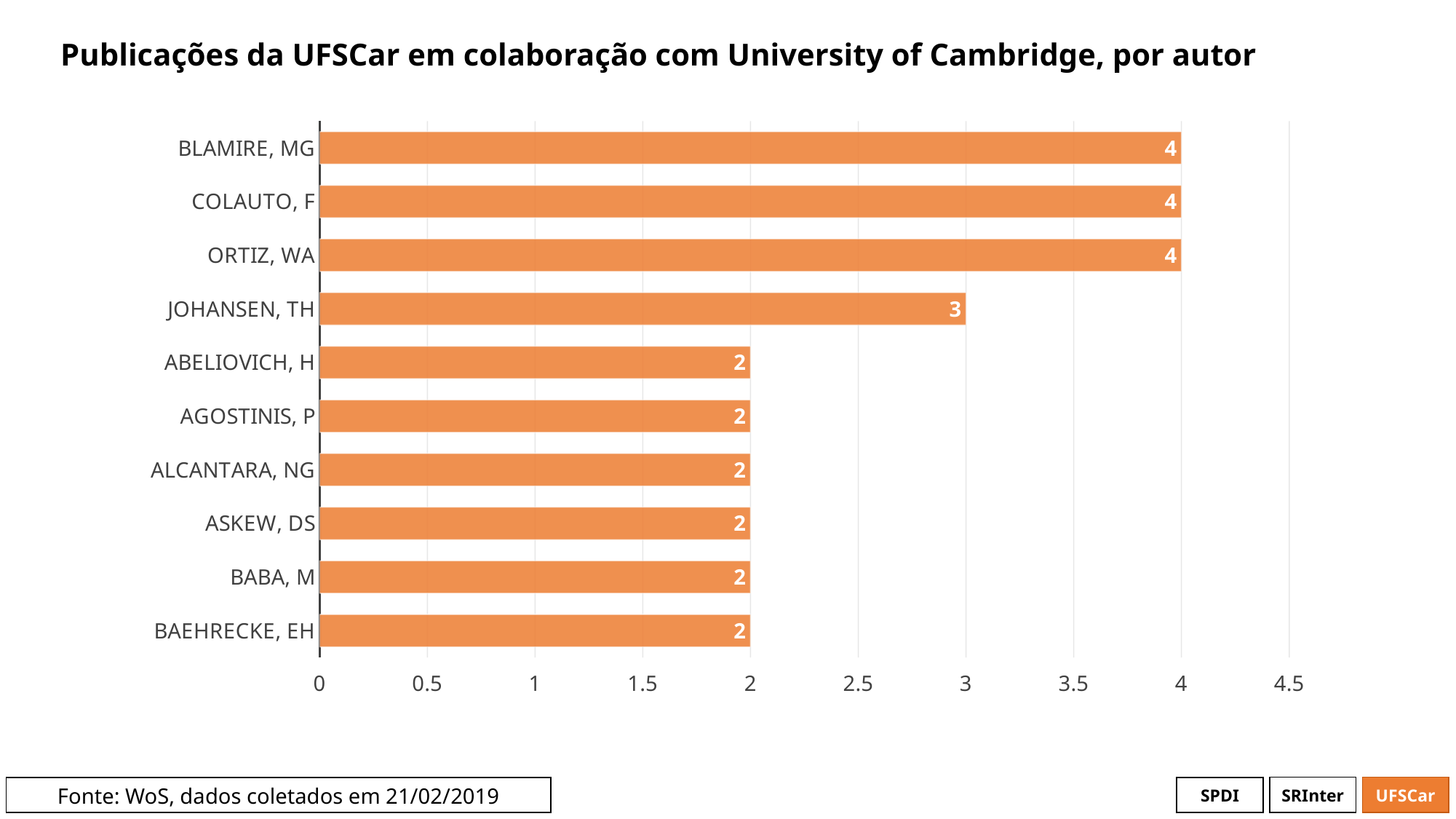
What is the value for JOHANSEN, TH? 3 Which is larger, the value for BABA, M or the value for JOHANSEN, TH? JOHANSEN, TH What is the difference between the values for COLAUTO, F and JOHANSEN, TH? 1 How many authors are shown in the chart? 10 What kind of chart is shown on the slide? Bar chart What is the difference between the values for JOHANSEN, TH and ASKEW, DS? 1 What is the highest value shown on the x axis? 4.5 What is the value for ORTIZ, WA? 4 Which is larger, the value for ORTIZ, WA or the value for ABELIOVICH, H? ORTIZ, WA What is the value for BAEHRECKE, EH? 2 What is the value for BLAMIRE, MG? 4 What is the title of the chart? Publicações da UFSCar em colaboração com University of Cambridge, por autor